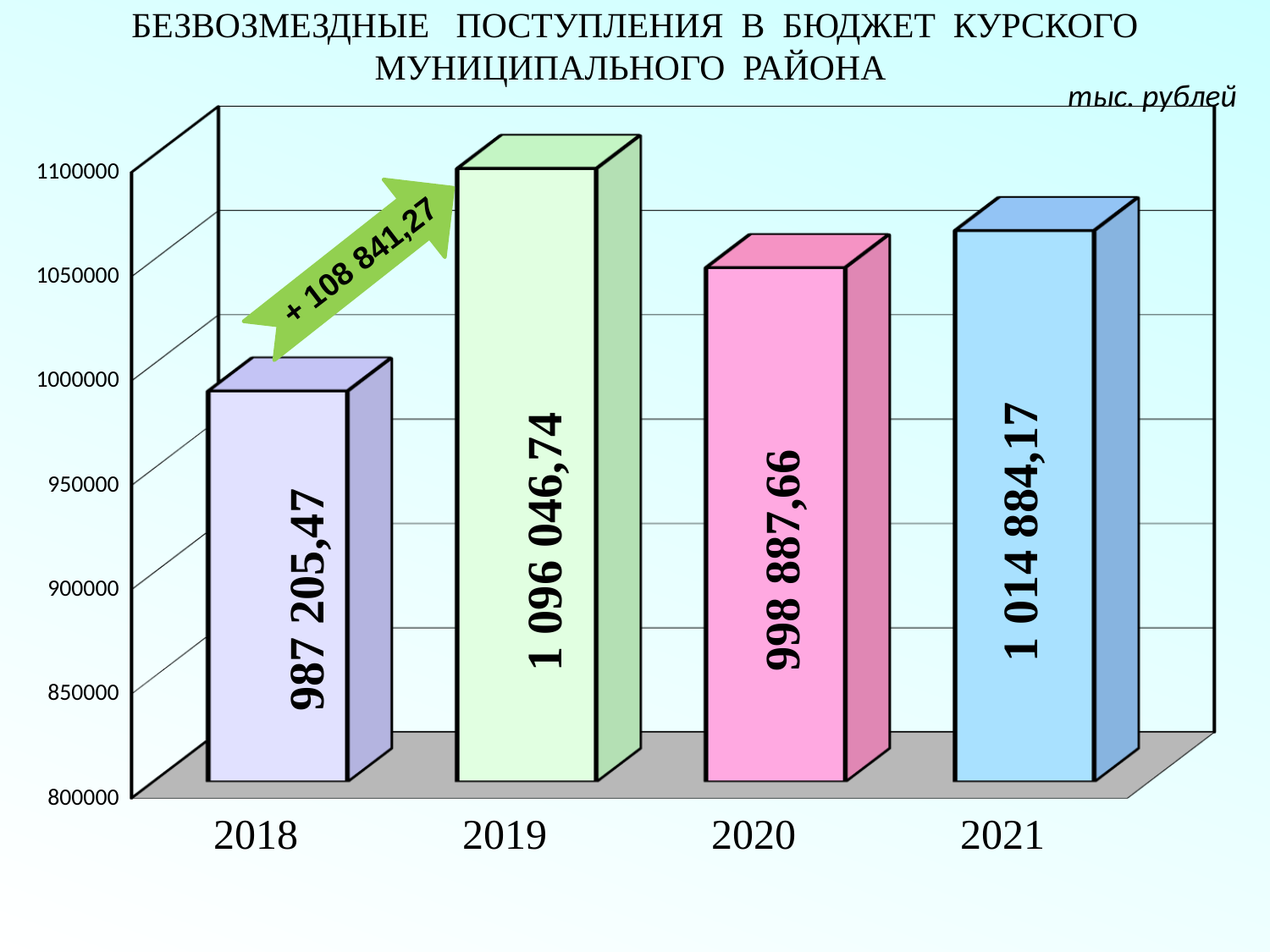
What is the value for 2019? 1 096 046,74 What is the difference between the values for 2021 and 2020? 15 996,51 What kind of chart is shown on the slide? bar chart Is the value for 2020 greater or less than 1050000? less How many years are shown on the chart? 4 What is the value for 2021? 1 014 884,17 Which is larger, the value for 2020 or the value for 2021? 2021 Which year has the lowest value? 2018 What is the value for 2020? 998 887,66 What is the difference between the values for 2019 and 2018? 108 841,27 What is the value for 2018? 987 205,47 Which year has the highest value? 2019